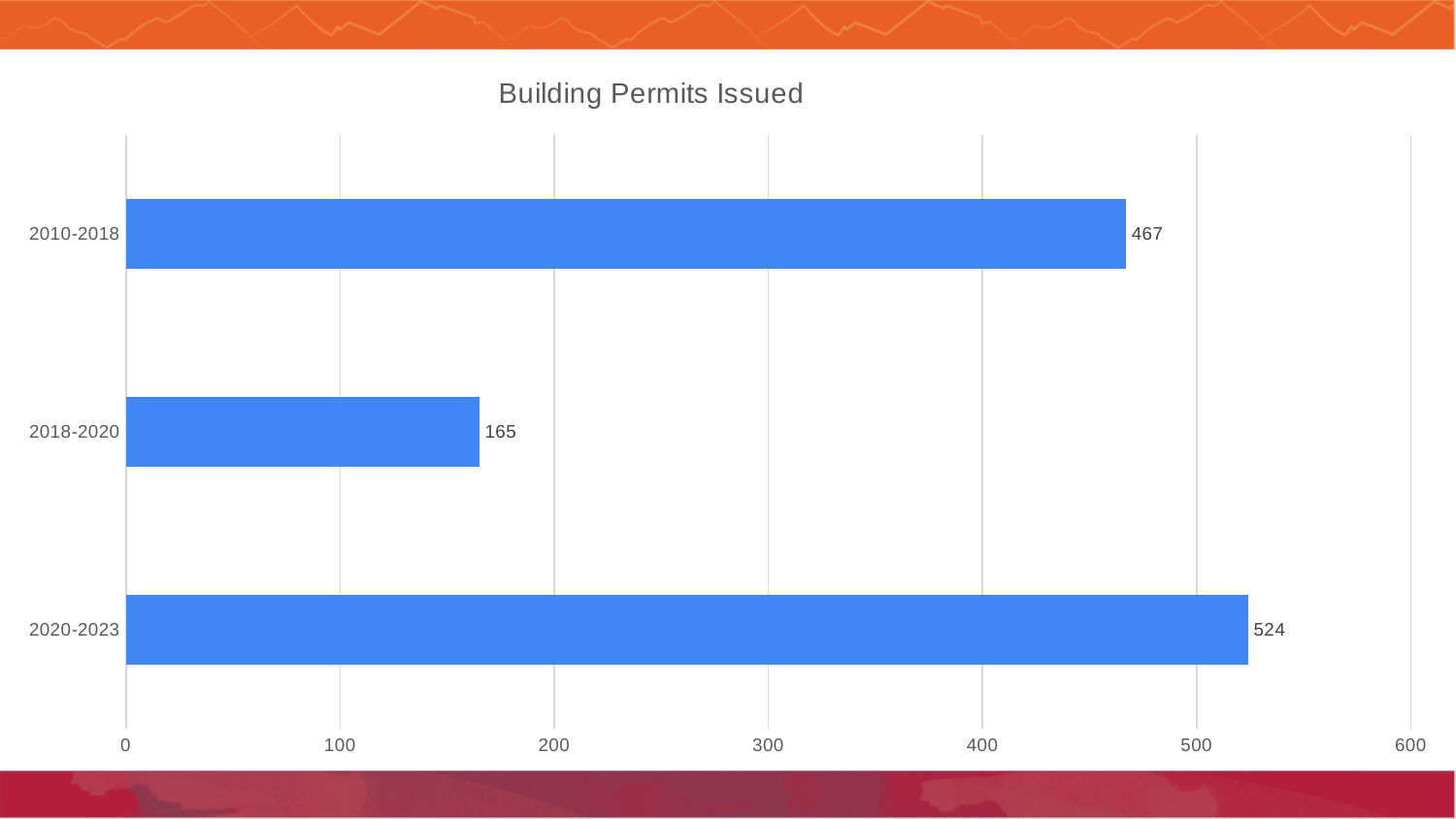
Which period had the lowest number of building permits issued? 2018-2020 What is the difference in building permits issued between 2020-2023 and 2010-2018? 57 What is the title of the chart? Building Permits Issued What type of chart is shown on the slide? Bar chart How many periods are shown in the chart? 3 Which period had the highest number of building permits issued? 2020-2023 How many building permits were issued in 2010-2018? 467 What is the difference in building permits issued between 2010-2018 and 2018-2020? 302 How many building permits were issued in 2018-2020? 165 Is the value for 2018-2020 greater or less than 200? less How many building permits were issued in 2020-2023? 524 Which period had more building permits issued, 2010-2018 or 2018-2020? 2010-2018